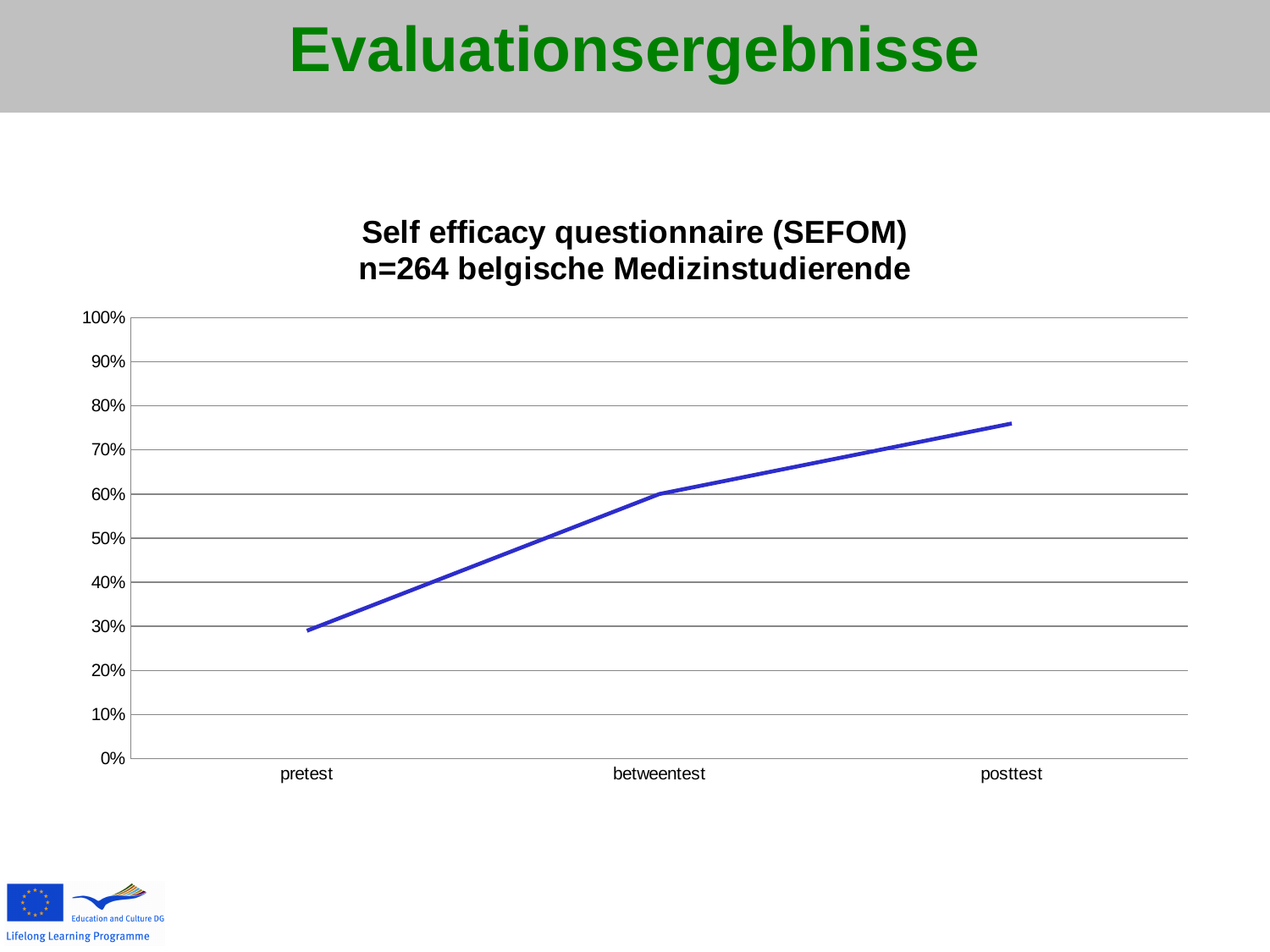
Which test point has the lowest value in the chart? pretest Which is larger, the value for betweentest or the value for pretest? betweentest Is the value for posttest greater or less than 80%? less According to the chart title, how many students (n) were surveyed? 264 Which is larger, the value for pretest or the value for posttest? posttest Is the value for pretest greater or less than 20%? greater Do the values rise or fall from pretest to posttest? rise Is the value for betweentest greater or less than 50%? greater How many points are plotted along the x axis of the chart? 3 What kind of chart is shown on the slide? line chart Which test point has the highest value in the chart? posttest